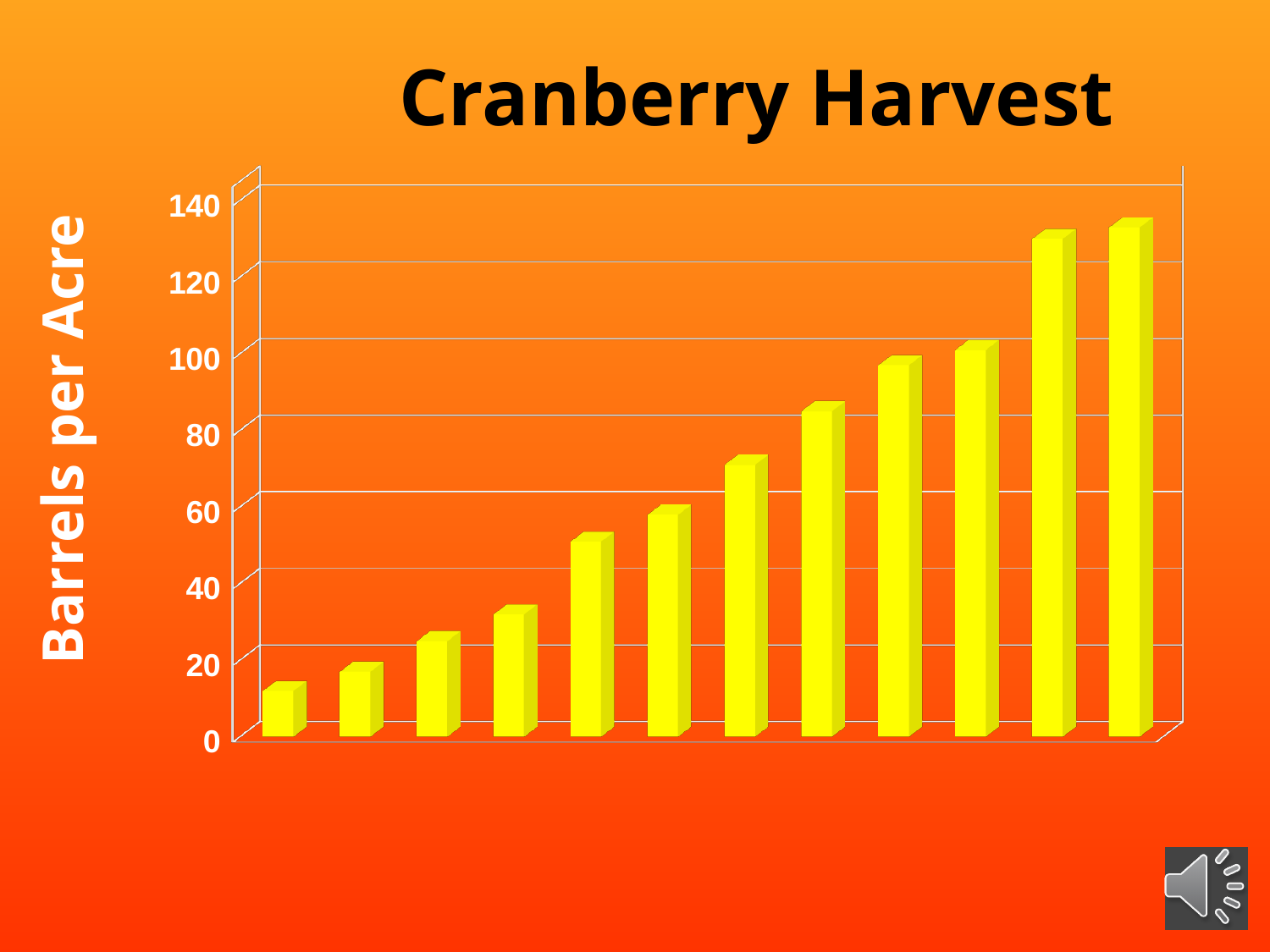
What kind of chart is shown on the slide? bar chart Do the bar values rise or fall from left to right across the chart? rise How many bars are plotted in the Cranberry Harvest chart? 12 Is the value of the fifth bar from the left greater or less than 40? greater Is the value of the seventh bar from the left greater or less than 60? greater What is the title of the chart? Cranberry Harvest Which bar has the lowest value, the leftmost bar or the rightmost bar? the leftmost bar Is the value of the eighth bar from the left greater or less than 100? less What is the label on the vertical axis of the chart? Barrels per Acre